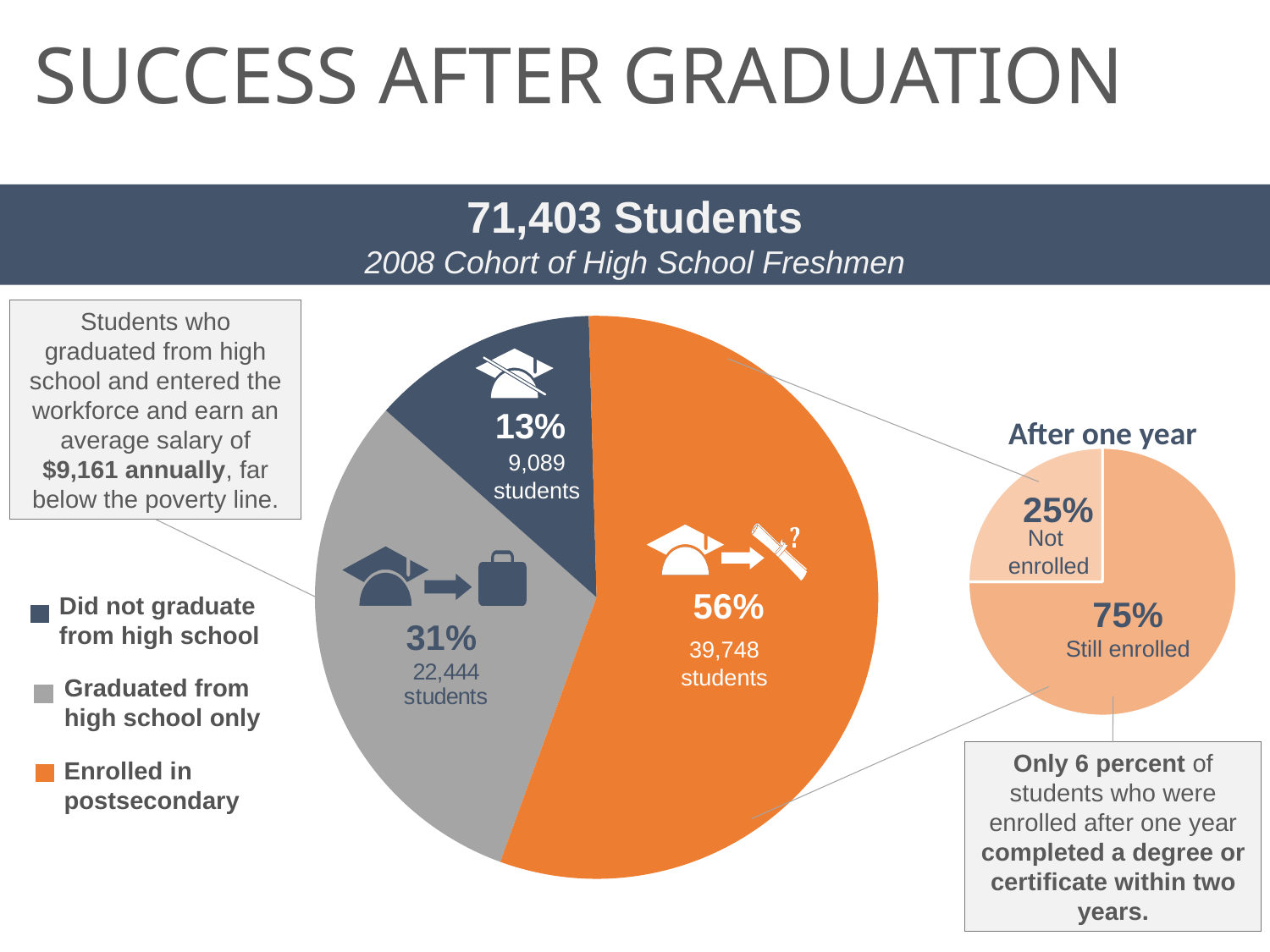
In the 'After one year' pie chart, what percentage of students were still enrolled? 75% In the main pie chart, what colour represents 'Enrolled in postsecondary'? Orange In the main pie chart, what percentage of students were enrolled in postsecondary? 56% In the main pie chart, which category has the largest share? Enrolled in postsecondary In the main pie chart, how many students did not graduate from high school? 9,089 students In the 'After one year' pie chart, which is larger: 'Not enrolled' or 'Still enrolled'? Still enrolled In the main pie chart, which category has the smallest share? Did not graduate from high school What type of chart is used to show the 2008 cohort breakdown? Pie chart In the main pie chart, how many categories are shown? 3 In the main pie chart, how many more students were enrolled in postsecondary than graduated from high school only? 17,304 In the main pie chart, what percentage of students graduated from high school only? 31% In the main pie chart, what is the difference in percentage points between 'Graduated from high school only' and 'Did not graduate from high school'? 18